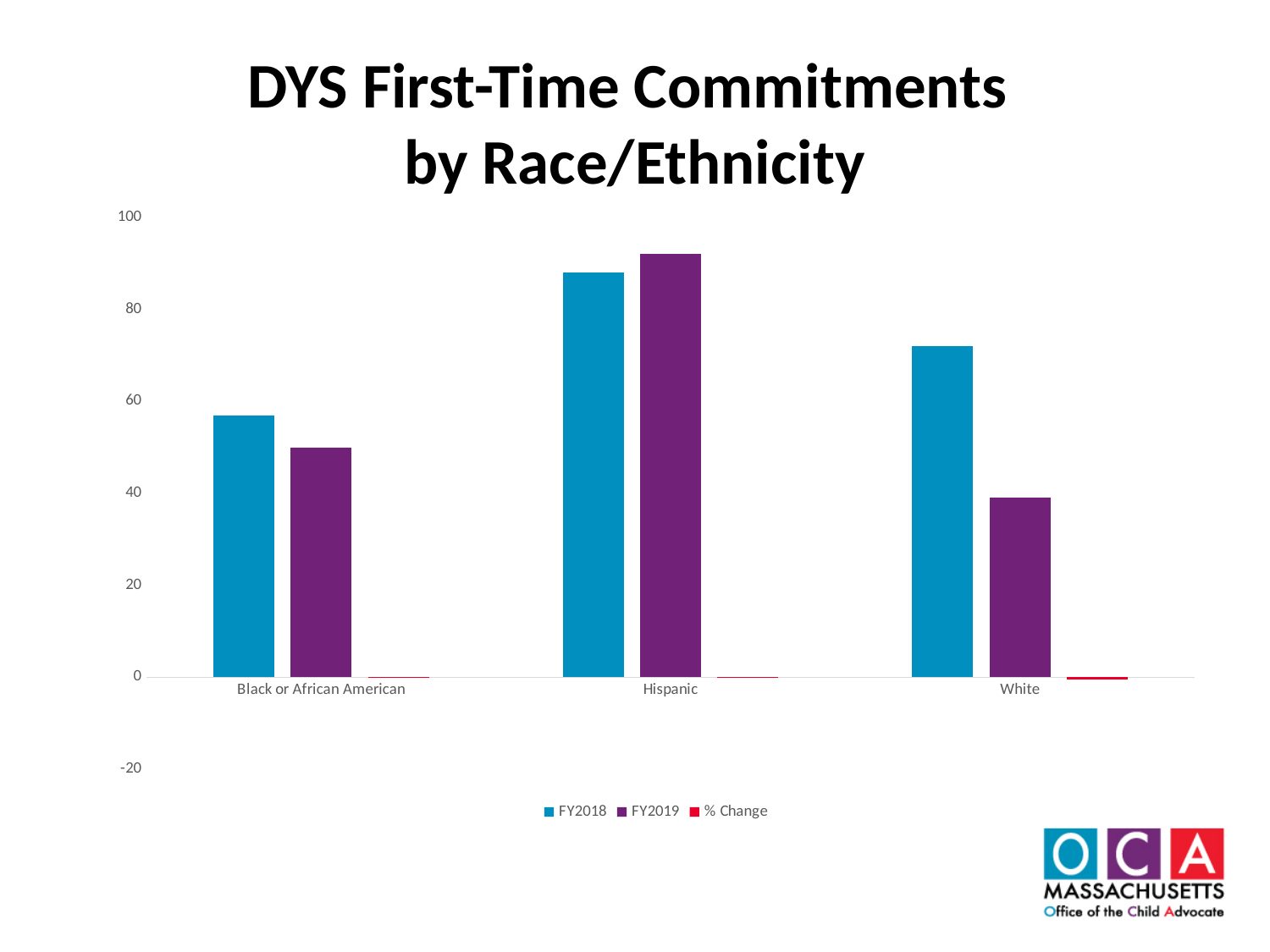
Is the FY2018 value for Hispanic greater or less than 80? greater For Hispanic, which is larger: the FY2018 value or the FY2019 value? FY2019 How many race/ethnicity categories are shown on the x axis? 3 What kind of chart is shown on the slide? bar chart Which category has the highest FY2018 value? Hispanic Which category has the highest FY2019 value? Hispanic For White, which is larger: the FY2018 value or the FY2019 value? FY2018 Which category has the lowest FY2019 value? White Which category has the lowest FY2018 value? Black or African American How many series does the legend list? 3 What is the title of the chart? DYS First-Time Commitments by Race/Ethnicity